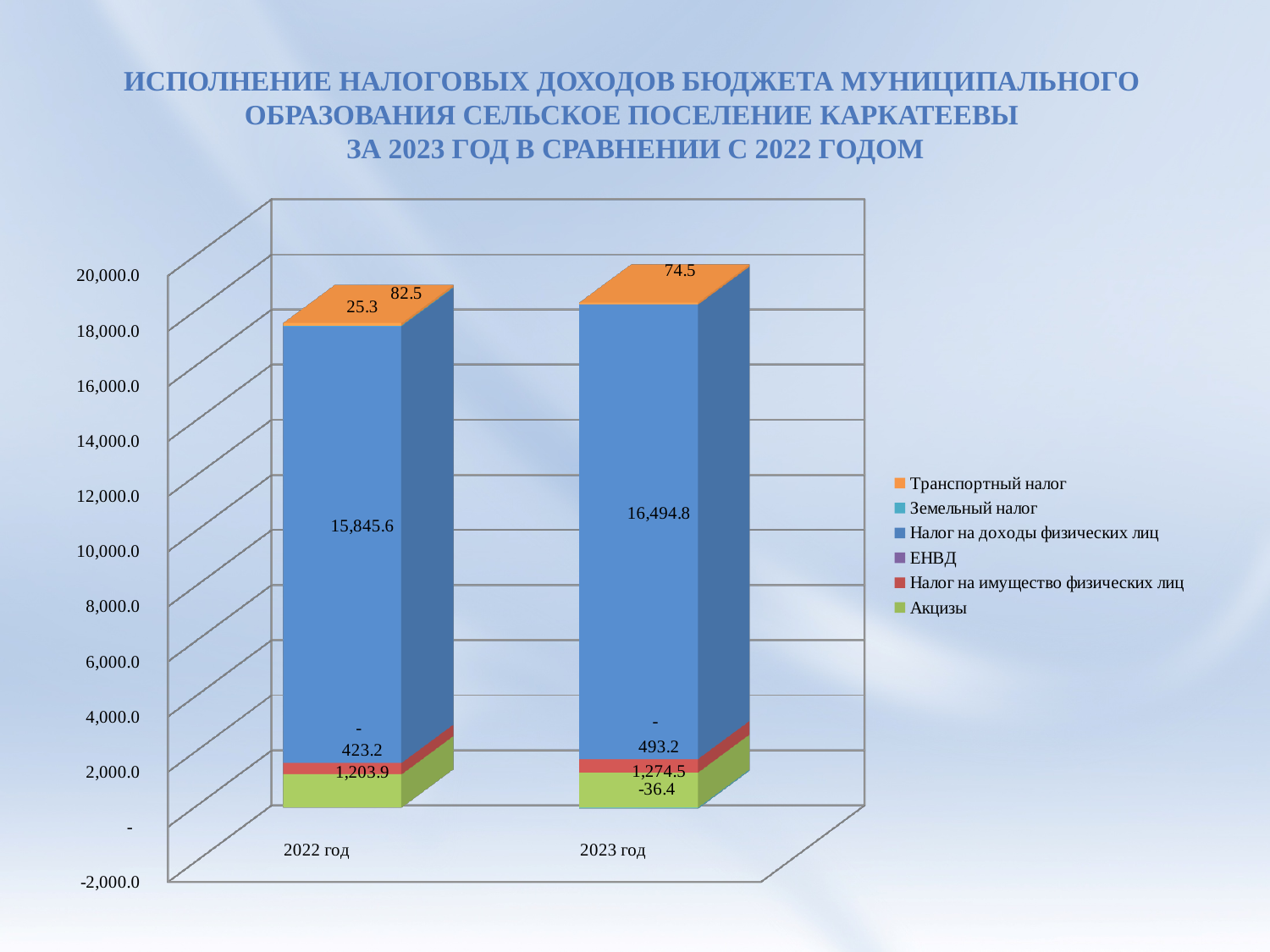
What is the value of Налог на имущество физических лиц for 2023 год? 493.2 How many series does the legend list? 6 Which colour represents Налог на доходы физических лиц in the legend? Blue What is the value of Акцизы for 2022 год? 1,203.9 What is the value of Налог на доходы физических лиц for 2022 год? 15,845.6 By how much did Налог на доходы физических лиц increase from 2022 год to 2023 год? 649.2 How many year categories are shown on the x axis? 2 What is the difference in Акцизы between 2023 год and 2022 год? 70.6 What is the value of Акцизы for 2023 год? 1,274.5 Which year has the larger value for Налог на имущество физических лиц, 2022 год or 2023 год? 2023 год What kind of chart is shown on the slide? Stacked bar chart What is the value of Налог на доходы физических лиц for 2023 год? 16,494.8